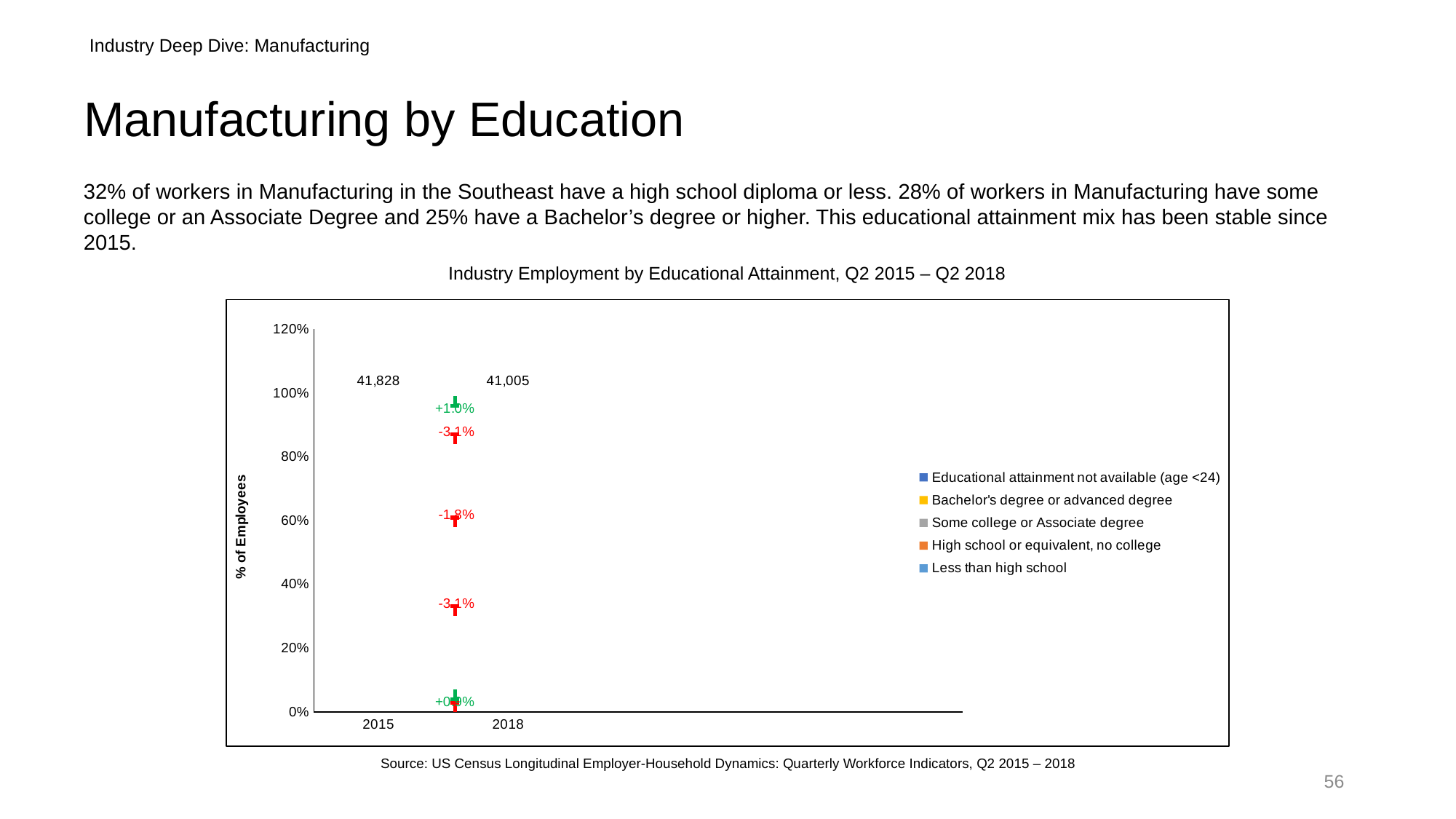
What total employment figure is printed above the 2018 column? 41,005 What is the highest tick value shown on the y axis? 120% What is the difference between the total employment figures printed for 2015 and 2018? 823 How many years are shown on the x axis of the chart? 2 What is the title of the chart? Industry Employment by Educational Attainment, Q2 2015 – Q2 2018 Which year has the larger total employment figure printed above it, 2015 or 2018? 2015 Which legend entry is listed first (at the top) in the chart's legend? Educational attainment not available (age <24) What is the label on the y axis of the chart? % of Employees What total employment figure is printed above the 2015 column? 41,828 How many series does the chart's legend list? 5